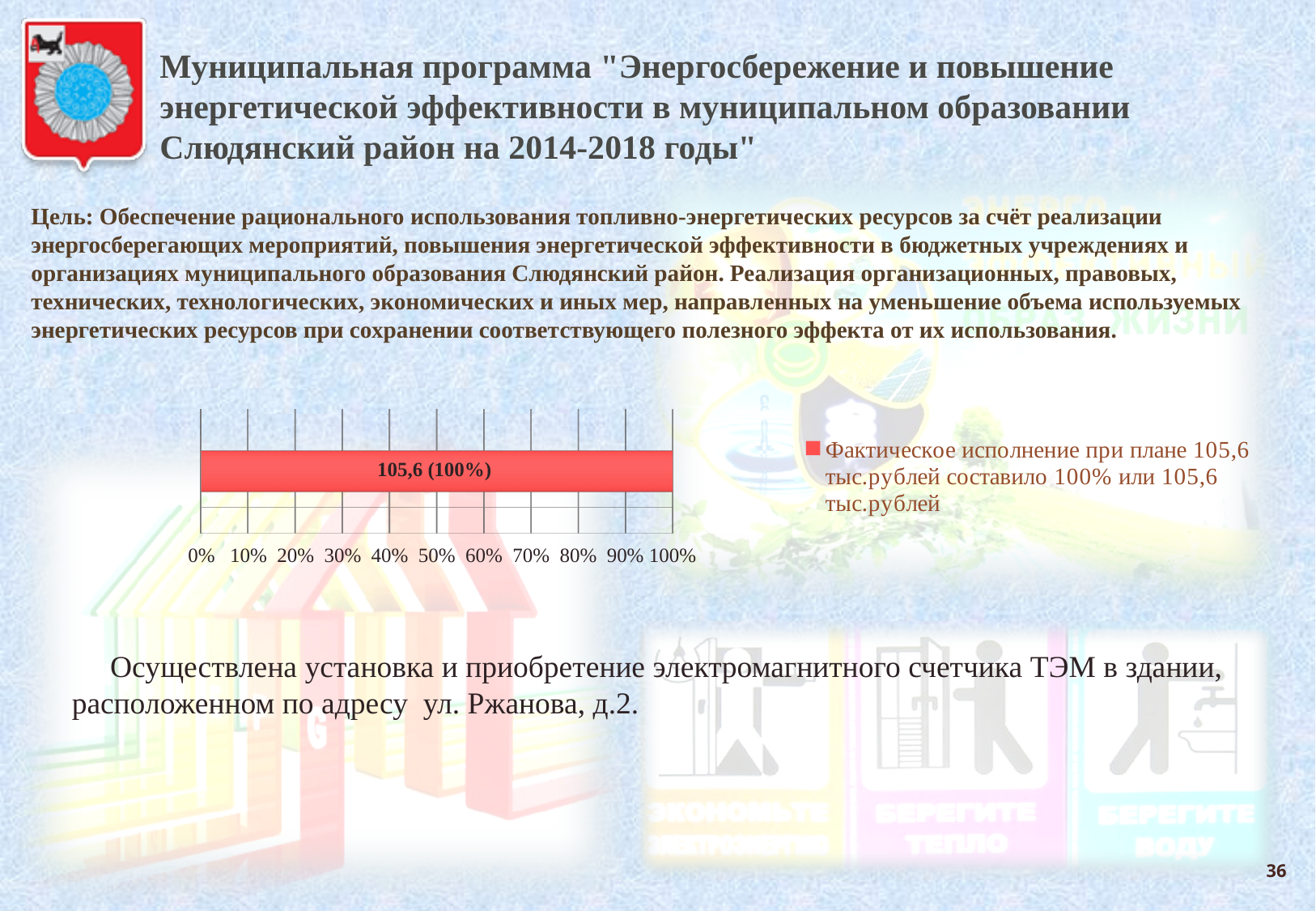
What data label is printed on the bar in the chart? 105,6 (100%) What is the highest tick value shown on the chart's horizontal axis? 100% What percentage does the bar in the chart reach? 100% What kind of chart is shown on the slide? bar chart What colour is the bar in the chart? red Is the value of the bar in the chart greater or less than 50%? greater How many bars are plotted in the chart? 1 According to the chart's data label, what is the actual execution amount in thousand rubles? 105,6 How many series does the chart legend list? 1 Is the value of the bar in the chart greater or less than 90%? greater